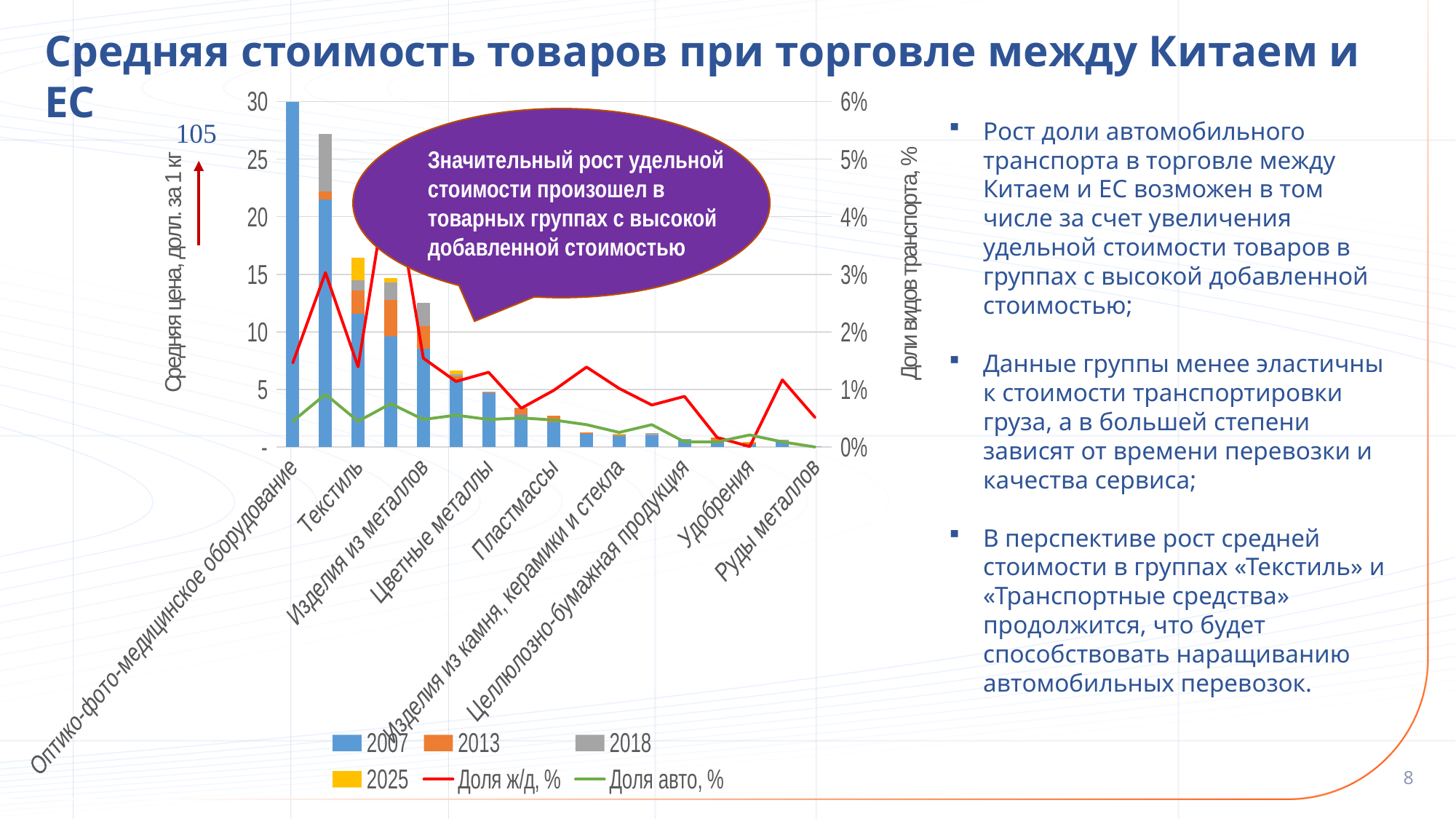
Is the bar value for Руды металлов greater or less than 5? less What kind of chart is shown on the slide? A combination of a stacked bar chart and line chart Which series is drawn as a green line? Доля авто, % Is the Доля авто, % value for Оптико-фото-медицинское оборудование greater or less than 1%? less Is the bar value for Текстиль greater or less than 10? greater How many series does the legend list? 6 Which category has the highest bar, Оптико-фото-медицинское оборудование or Руды металлов? Оптико-фото-медицинское оборудование Do the bar heights generally rise or fall from left to right along the x axis? Fall Which series is drawn as a red line? Доля ж/д, %